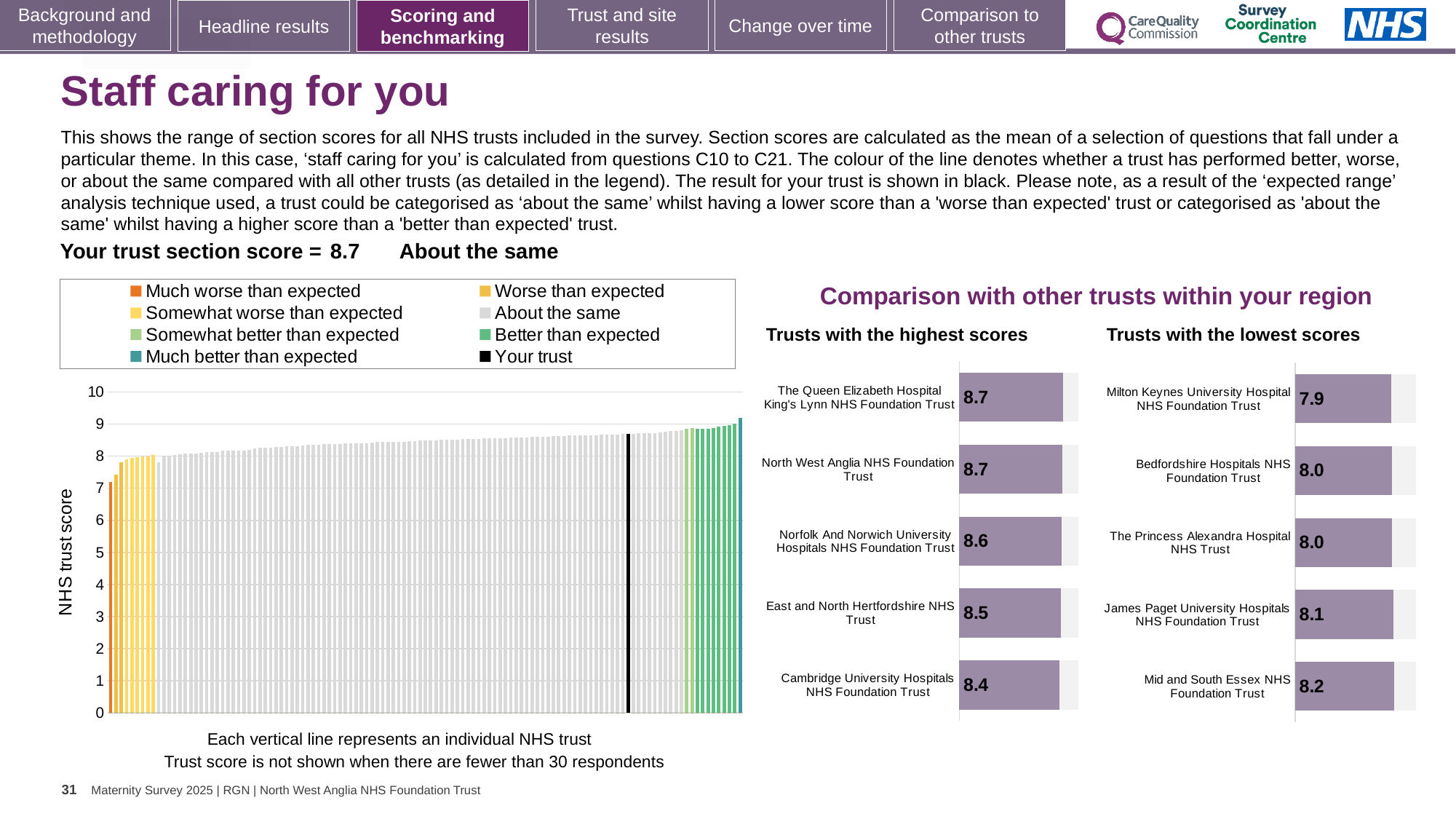
How many trusts are listed in the 'Trusts with the highest scores' chart? 5 In the 'Trusts with the lowest scores' chart, which trust has the lowest score? Milton Keynes University Hospital NHS Foundation Trust What type of chart is the large chart on the left of the slide? Bar chart What is the section score for your trust shown on the slide? 8.7 In the 'Trusts with the highest scores' chart, what is the difference between the score for North West Anglia NHS Foundation Trust and the score for Cambridge University Hospitals NHS Foundation Trust? 0.3 In the large chart on the left, is the value for the black bar (your trust) greater or less than 8? greater In the 'Trusts with the highest scores' chart, what is the score for Cambridge University Hospitals NHS Foundation Trust? 8.4 In the 'Trusts with the highest scores' chart, what is the score for Norfolk And Norwich University Hospitals NHS Foundation Trust? 8.6 In the 'Trusts with the lowest scores' chart, what is the score for Milton Keynes University Hospital NHS Foundation Trust? 7.9 In the 'Trusts with the lowest scores' chart, which has the larger score: James Paget University Hospitals NHS Foundation Trust or Bedfordshire Hospitals NHS Foundation Trust? James Paget University Hospitals NHS Foundation Trust In the 'Trusts with the lowest scores' chart, which trust has the highest score? Mid and South Essex NHS Foundation Trust How many entries does the legend above the large chart on the left list? 8